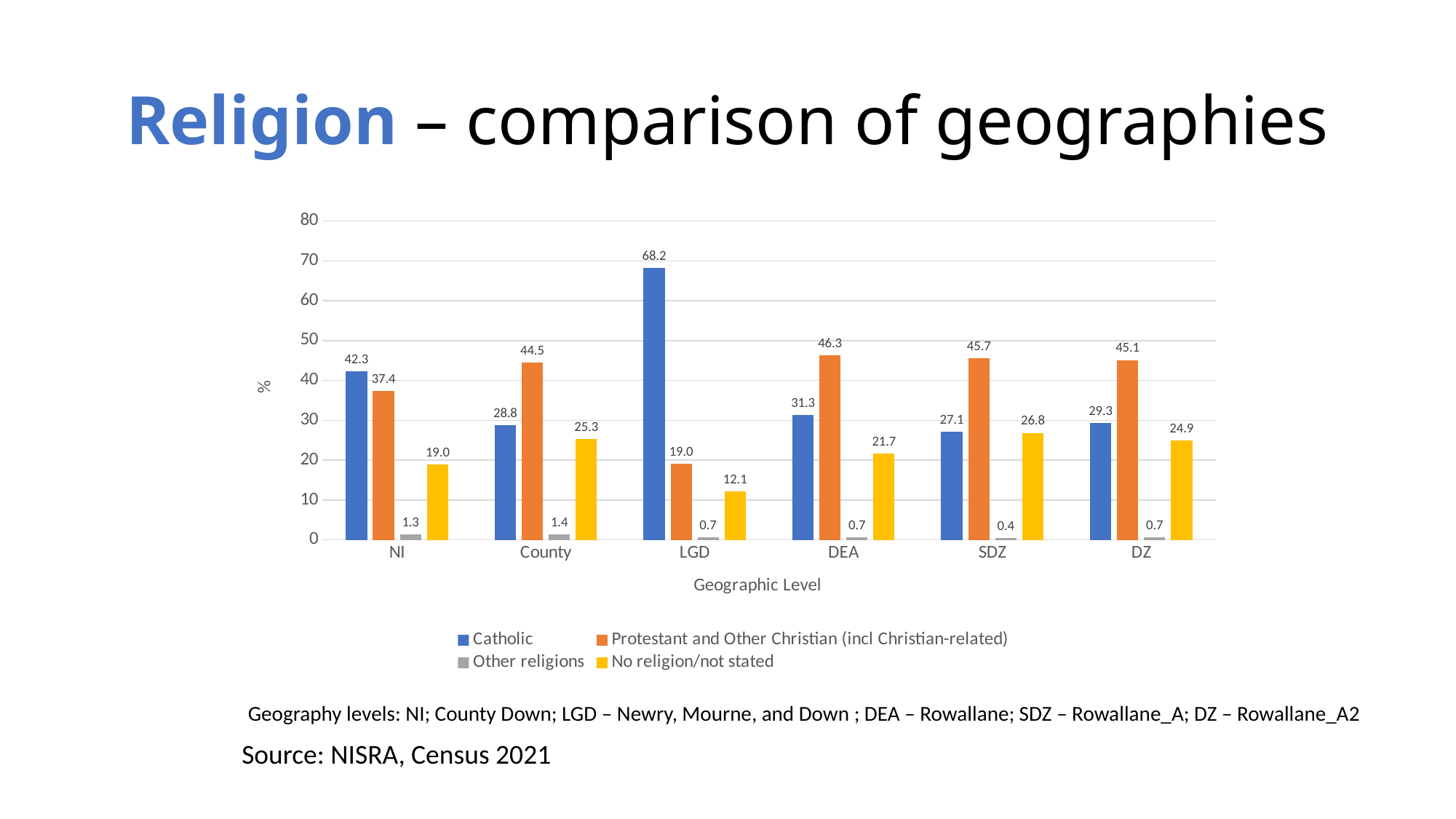
How many series does the legend list? 4 At DZ, which is larger: the Catholic value or the No religion/not stated value? Catholic Is the Catholic value for LGD greater or less than 60? greater What is the value for Protestant and Other Christian (incl Christian-related) at DEA? 46.3 What is the No religion/not stated value for County? 25.3 How many geographic levels are shown on the x axis? 6 What is the difference between the Catholic and Protestant and Other Christian values at NI? 4.9 What is the Catholic percentage for LGD? 68.2 What is the Other religions value for SDZ? 0.4 Which geographic level has the highest Catholic percentage? LGD Which geographic level has the lowest No religion/not stated percentage? LGD What kind of chart is shown on the slide? Bar chart